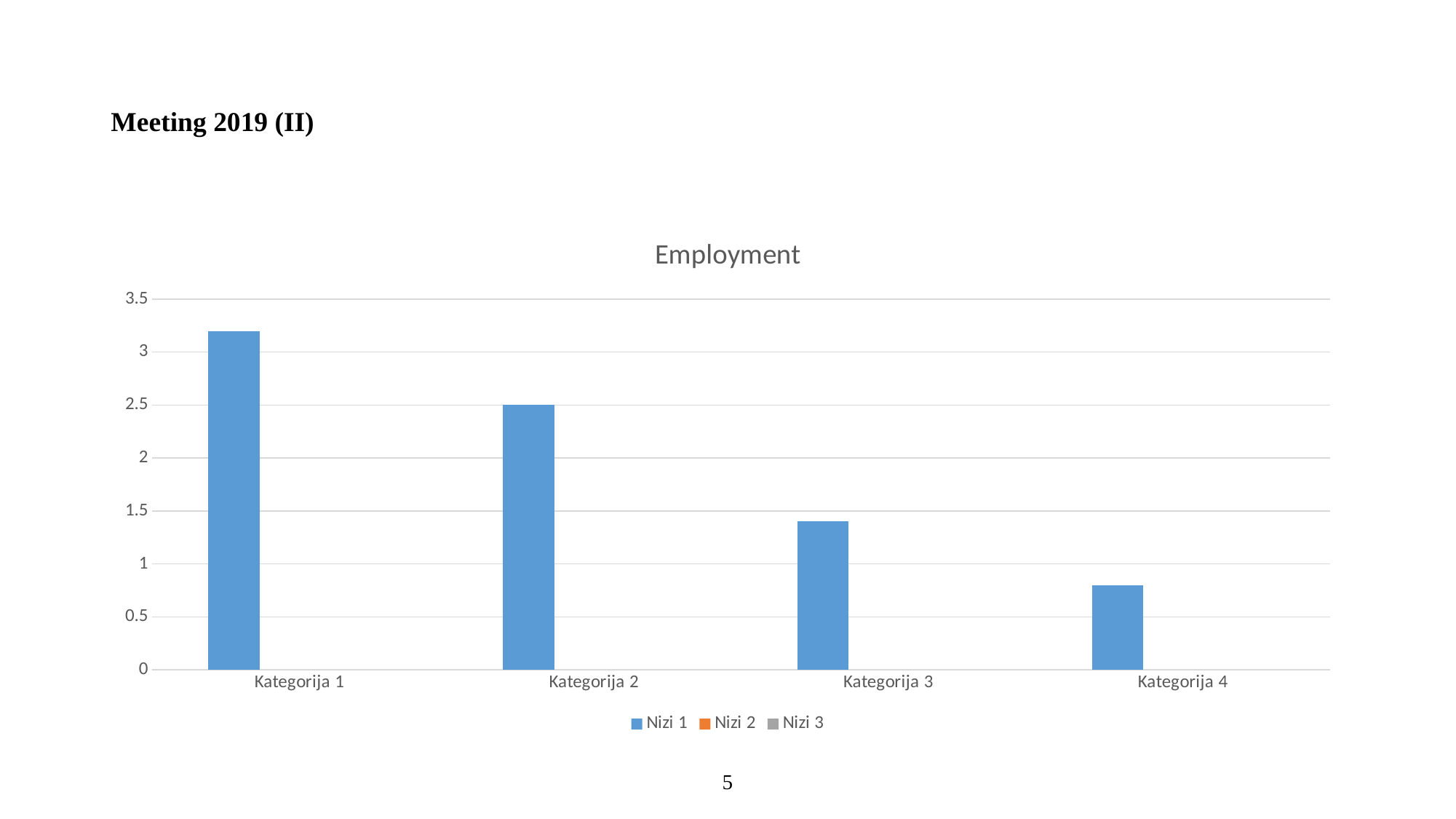
Do the values rise or fall from Kategorija 1 to Kategorija 4 in the Employment chart? fall Is the value for Kategorija 4 greater or less than 1? less Which category has the lowest value in the Employment chart? Kategorija 4 What is the value for Kategorija 2 in the Employment chart? 2.5 Which is larger in the Employment chart, the value for Kategorija 2 or the value for Kategorija 3? Kategorija 2 What is the title of the chart? Employment Which category has the highest value in the Employment chart? Kategorija 1 How many categories are shown on the x axis of the Employment chart? 4 What kind of chart is shown on the slide? bar chart Is the value for Kategorija 1 greater or less than 3? greater How many series does the legend of the Employment chart list? 3 Is the value for Kategorija 3 greater or less than 1.5? less